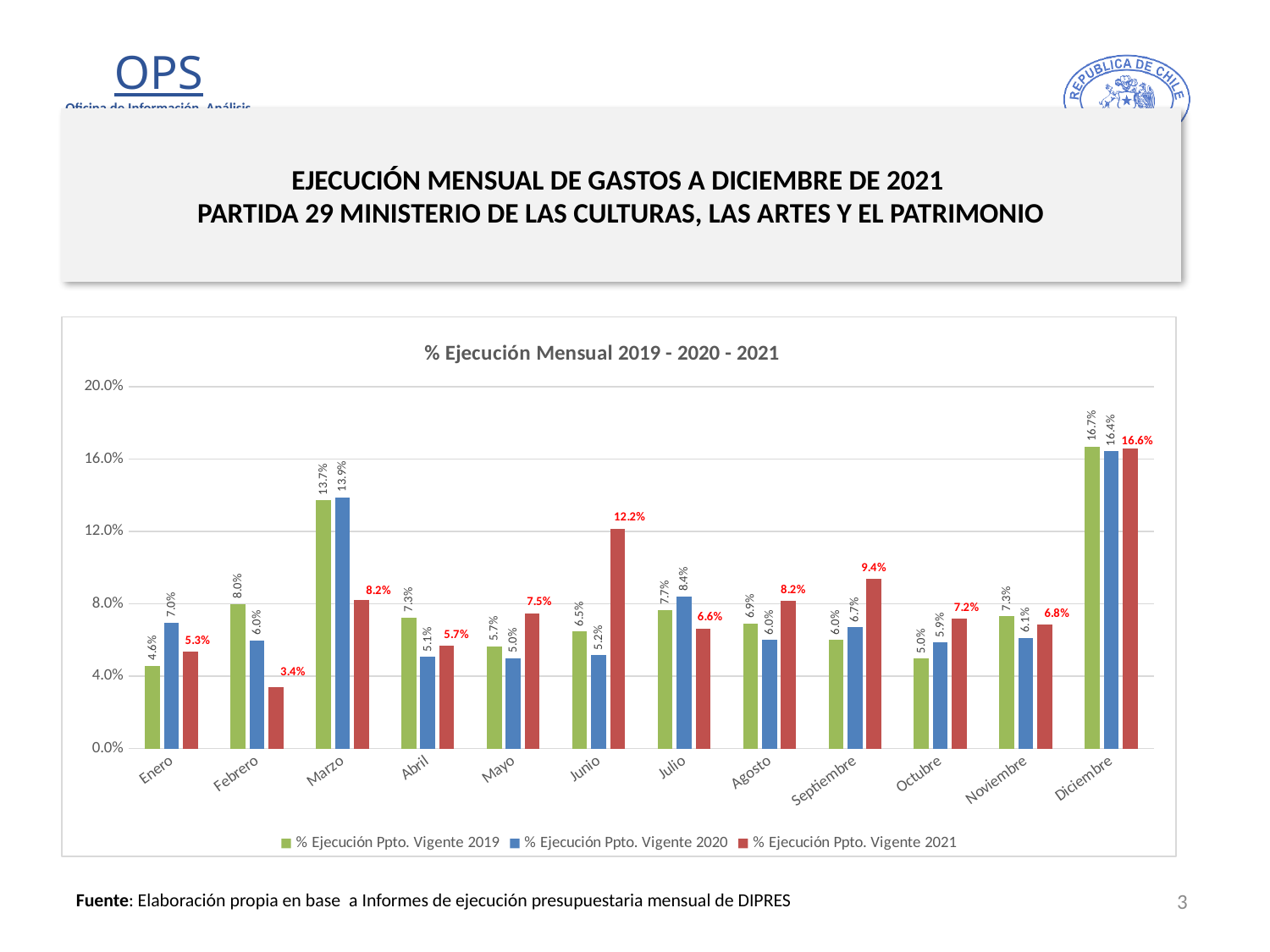
Which month has the highest value for % Ejecución Ppto. Vigente 2021? Diciembre What is the value for % Ejecución Ppto. Vigente 2021 in Junio? 12.2% What kind of chart is shown? bar chart How many series does the legend list? 3 What is the value for % Ejecución Ppto. Vigente 2020 in Julio? 8.4% How many months are shown on the x axis? 12 In Febrero, which is larger: the 2019 value or the 2021 value? 2019 Which month has the lowest value for % Ejecución Ppto. Vigente 2021? Febrero What is the value for % Ejecución Ppto. Vigente 2019 in Marzo? 13.7% What is the difference between the 2021 and 2020 values in Junio? 7.0% Is the value for % Ejecución Ppto. Vigente 2019 in Diciembre greater or less than 16.0%? greater What is the title of the chart? % Ejecución Mensual 2019 - 2020 - 2021